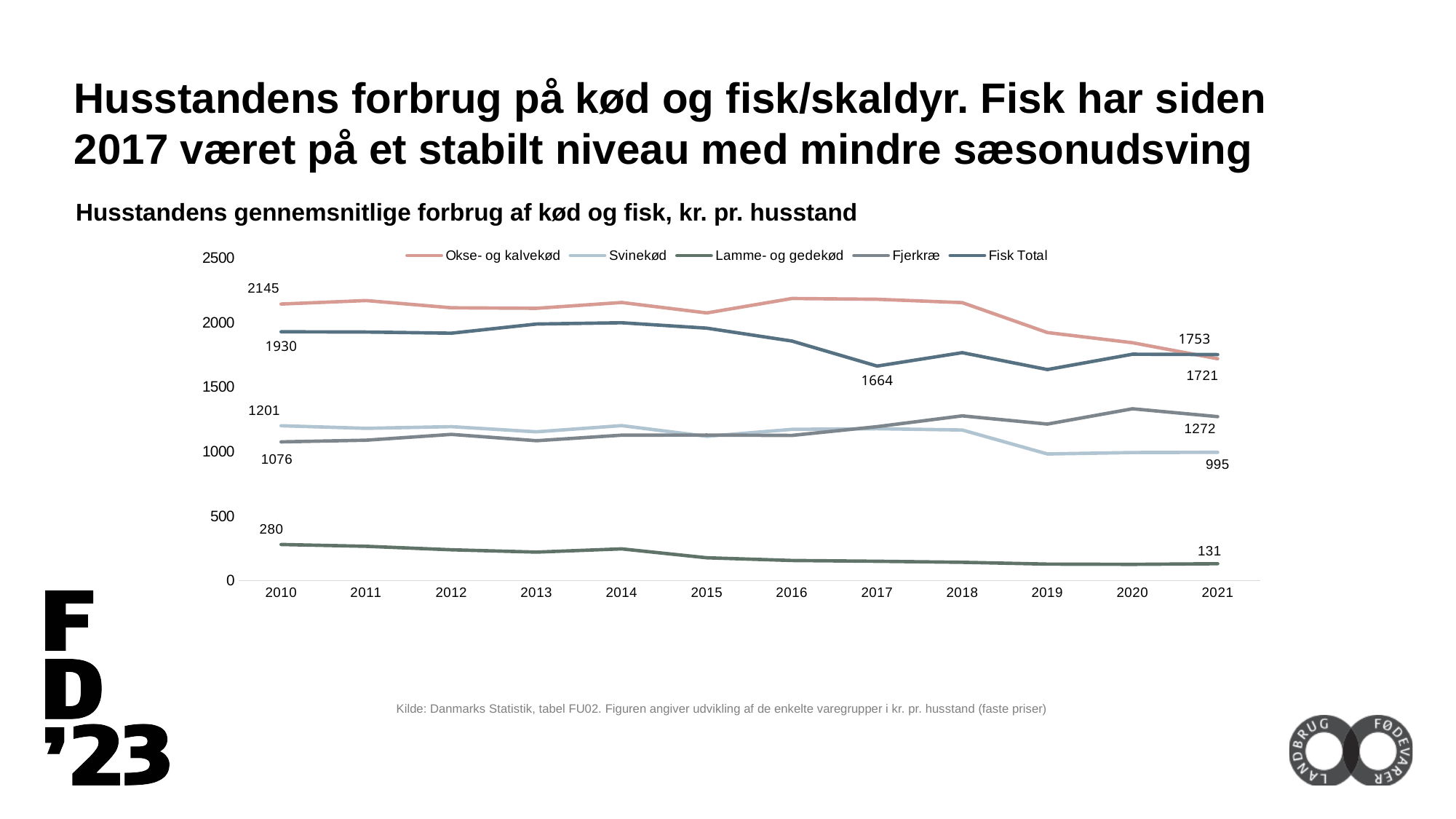
What is the value for Svinekød in 2021? 995 What kind of chart is shown on the slide? line chart How many years are shown on the x axis? 12 By how much did Lamme- og gedekød fall from 2010 to 2021? 149 What is the value for Fjerkræ in 2021? 1272 What is the value for Okse- og kalvekød in 2010? 2145 By how much did Svinekød fall from 2010 to 2021? 206 How many series does the legend list? 5 What is the value for Fisk Total in 2017? 1664 What is the value for Lamme- og gedekød in 2021? 131 Which is larger in 2021, Fjerkræ or Svinekød? Fjerkræ Which series has the lowest value in 2010? Lamme- og gedekød